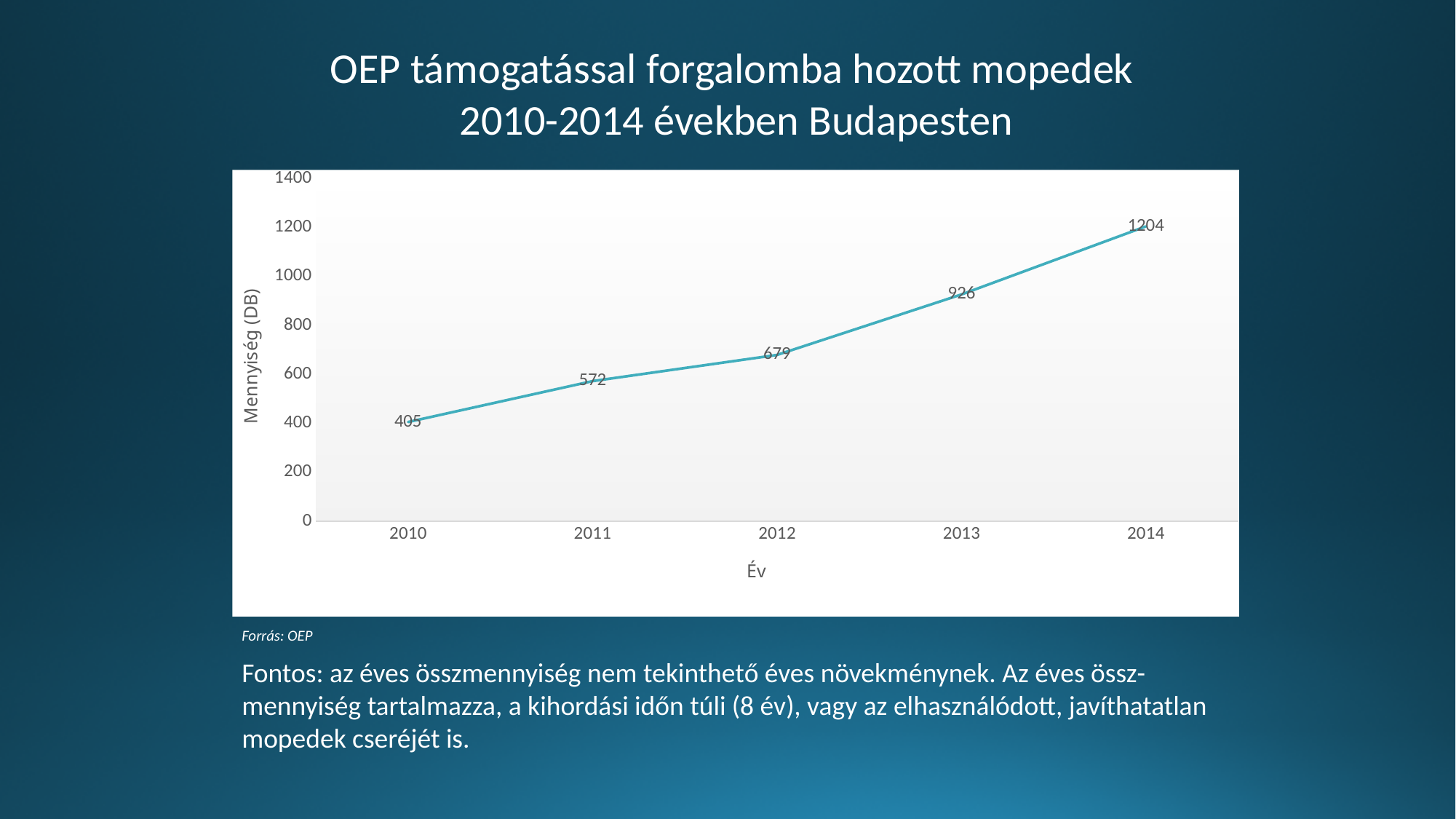
What is the value for 2014? 1204 Which is larger, the value for 2011 or the value for 2012? 2012 How many years are plotted on the chart? 5 What is the difference between the values for 2013 and 2011? 354 Which year has the lowest value? 2010 Is the value for 2013 greater or less than 800? greater What is the value for 2012? 679 What is the value for 2010? 405 Which year has the highest value? 2014 What kind of chart is shown on the slide? line chart What is the difference between the values for 2014 and 2010? 799 Do the values rise or fall from 2010 to 2014? rise